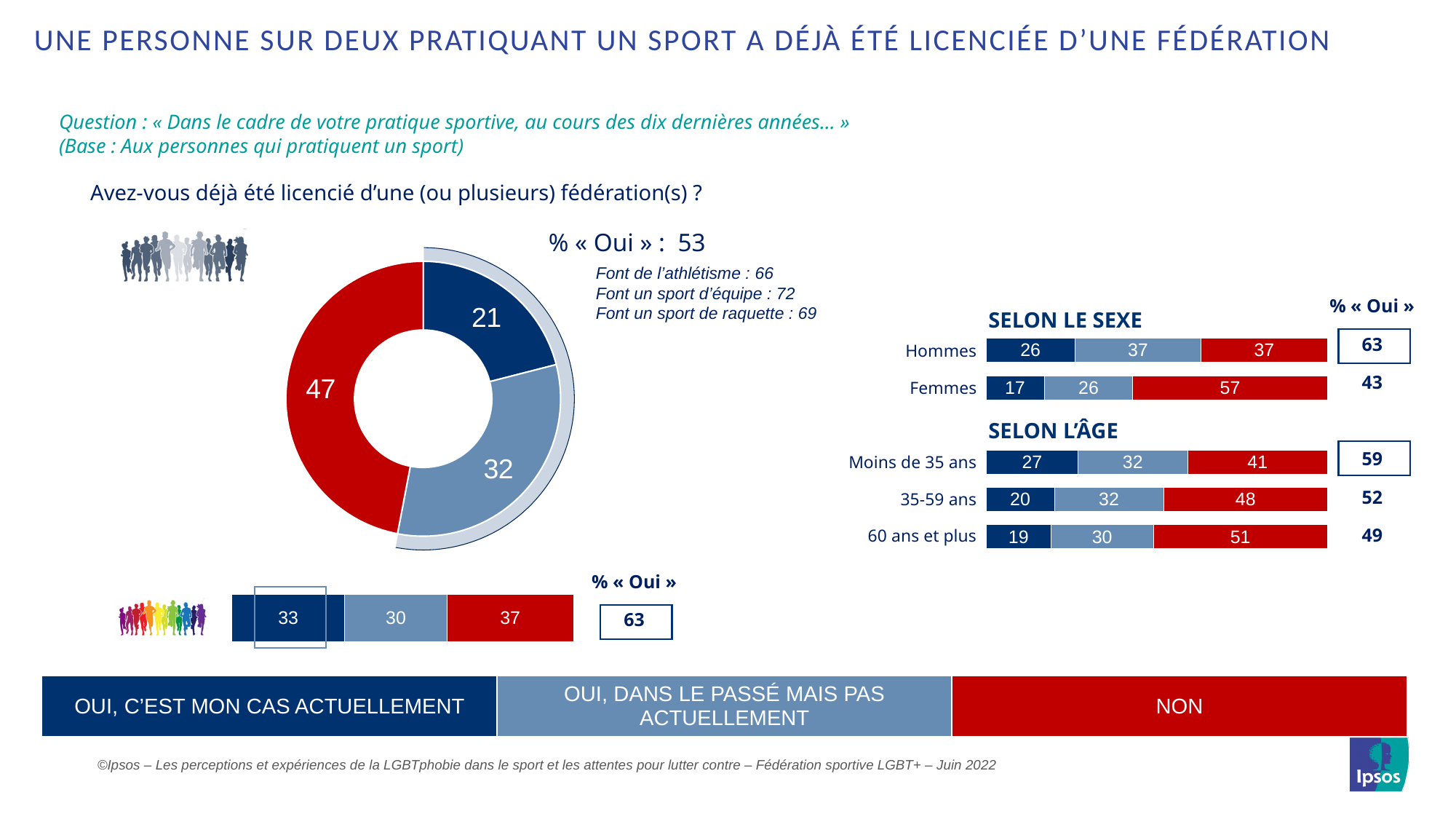
In the « Selon le sexe » bars, which group has the larger « Non » value, Hommes or Femmes? Femmes In the donut chart, which response has the smallest share? Oui, c'est mon cas actuellement In the « Selon l'âge » bars, what is the « Oui, c'est mon cas actuellement » value for 35-59 ans? 20 In the « Selon le sexe » bars, what is the % « Oui » for Hommes? 63 How many response categories does the legend at the bottom of the slide list? 3 In the donut chart, which response has the largest share? Non In the « Selon le sexe » bars, what is the « Non » value for Femmes? 57 In the bottom-left stacked bar, what is the total of the three segments (33, 30 and 37)? 100 In the « Selon l'âge » bars, what is the difference between the « Non » values for 60 ans et plus and Moins de 35 ans? 10 In the donut chart, what percentage answered « Oui, c'est mon cas actuellement »? 21 In the donut chart, what percentage answered « Non »? 47 In the « Selon l'âge » bars, which age group has the highest % « Oui »? Moins de 35 ans